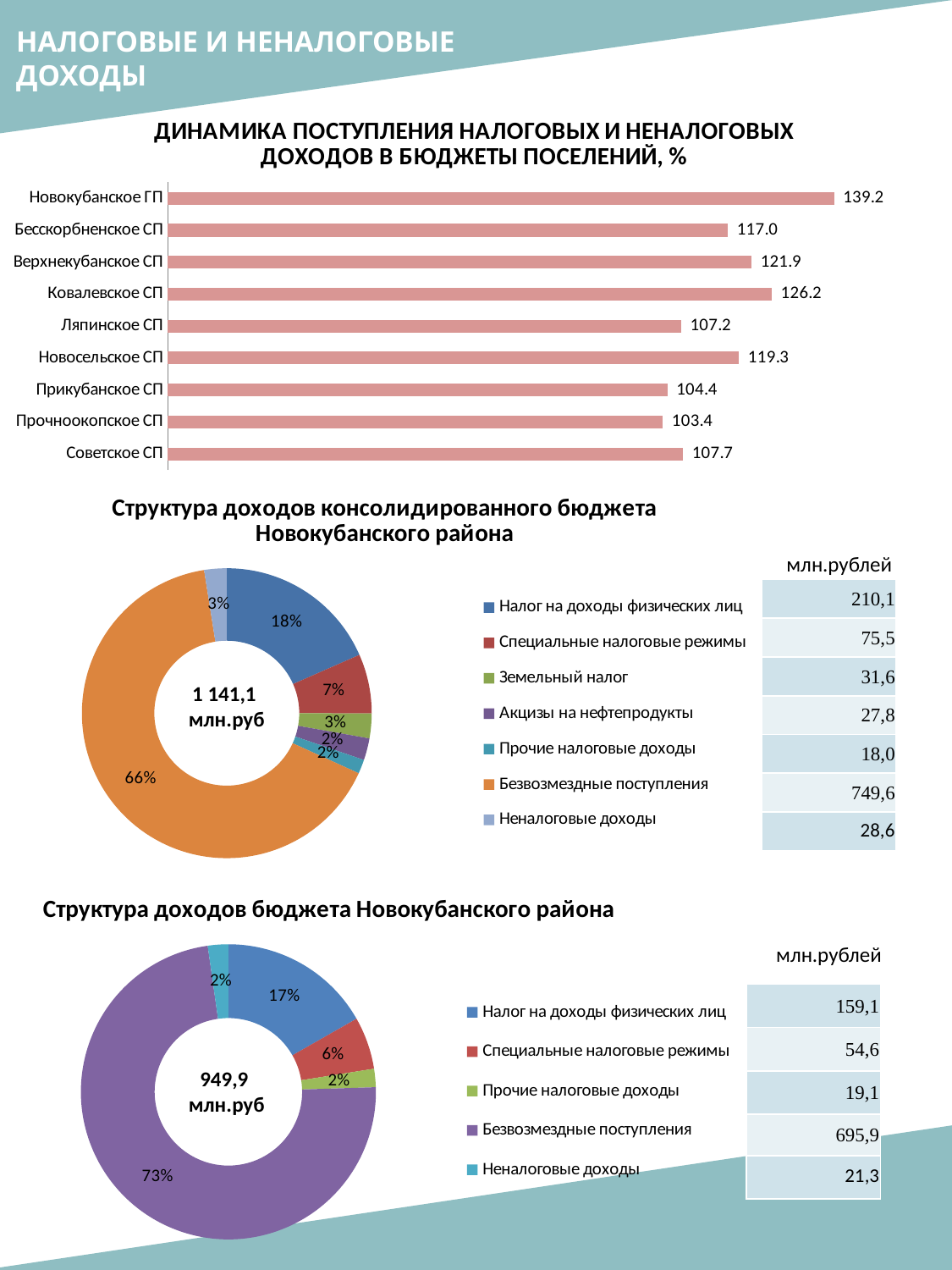
In the middle donut chart 'Структура доходов консолидированного бюджета Новокубанского района', what share does Безвозмездные поступления have? 66% In the top bar chart, which category has the lowest value? Прочноокопское СП In the top bar chart, which is larger: the value for Бесскорбненское СП or the value for Новосельское СП? Новосельское СП In the bottom donut chart 'Структура доходов бюджета Новокубанского района', what share does Безвозмездные поступления have? 73% In the top bar chart, what is the difference between the values for Новокубанское ГП and Ляпинское СП? 32.0 In the top bar chart, which category has the highest value? Новокубанское ГП What total is shown in the centre of the bottom donut chart 'Структура доходов бюджета Новокубанского района'? 949,9 млн.руб How many categories are shown in the top bar chart? 9 How many entries does the legend of the middle donut chart 'Структура доходов консолидированного бюджета Новокубанского района' list? 7 What type of chart is the top chart on the slide? Bar chart In the middle donut chart 'Структура доходов консолидированного бюджета Новокубанского района', what is the value in млн.рублей for Налог на доходы физических лиц? 210,1 In the top bar chart 'Динамика поступления налоговых и неналоговых доходов в бюджеты поселений, %', what is the value for Ковалевское СП? 126.2